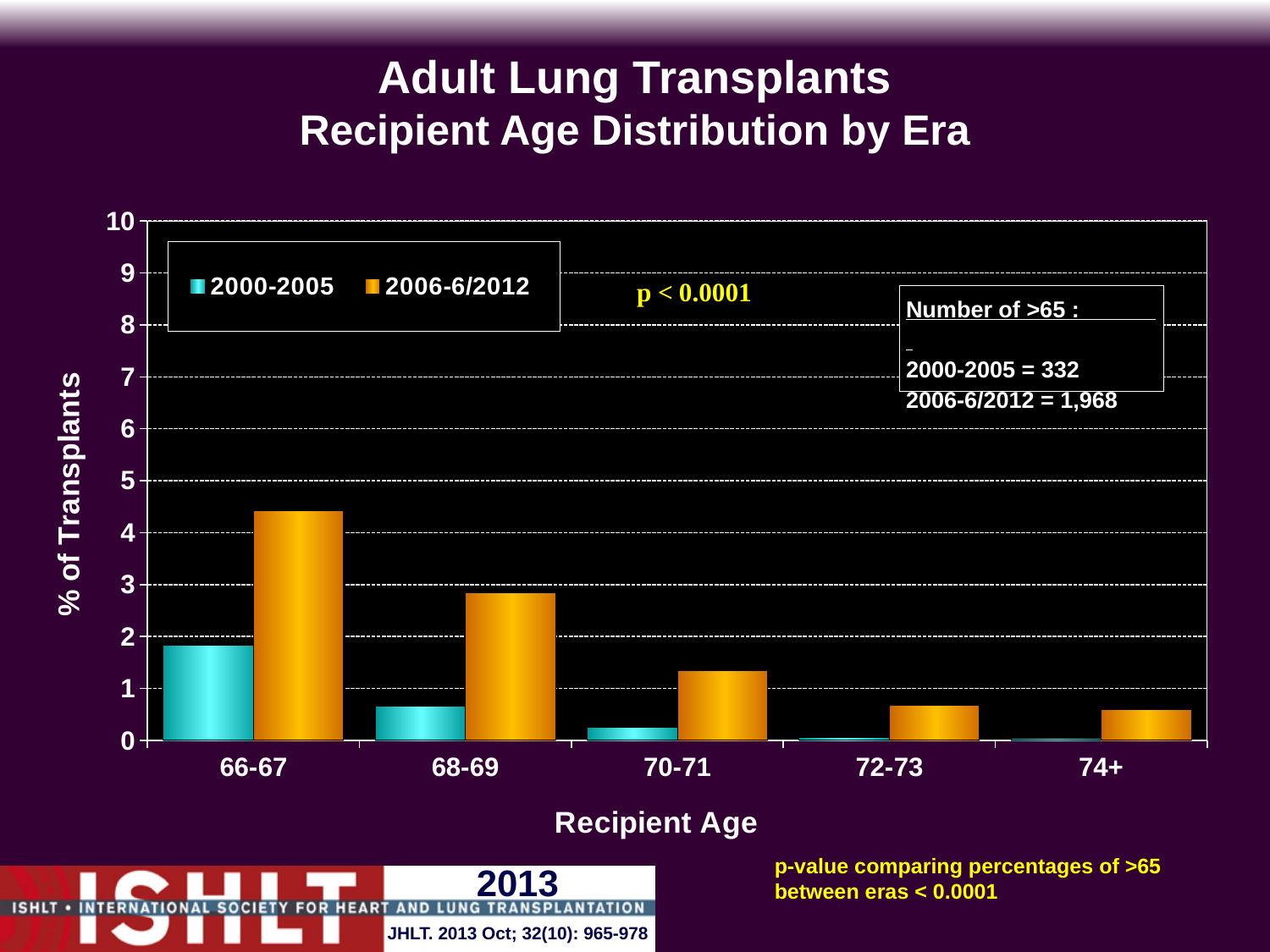
For the 66-67 age group, which series has the larger value, 2000-2005 or 2006-6/2012? 2006-6/2012 Is the value for the 2000-2005 series in the 66-67 age group greater or less than 2? less Is the value for the 2006-6/2012 series in the 70-71 age group greater or less than 1? greater Is the value for the 2000-2005 series in the 68-69 age group greater or less than 1? less Which recipient age group has the highest value for the 2006-6/2012 series? 66-67 How many recipient age groups are shown on the x axis? 5 How many series does the legend list? 2 What kind of chart is shown on the slide? bar chart What is the title of the y axis? % of Transplants Which recipient age group has the highest value for the 2000-2005 series? 66-67 Do the values for the 2006-6/2012 series rise or fall as recipient age increases along the x axis? fall